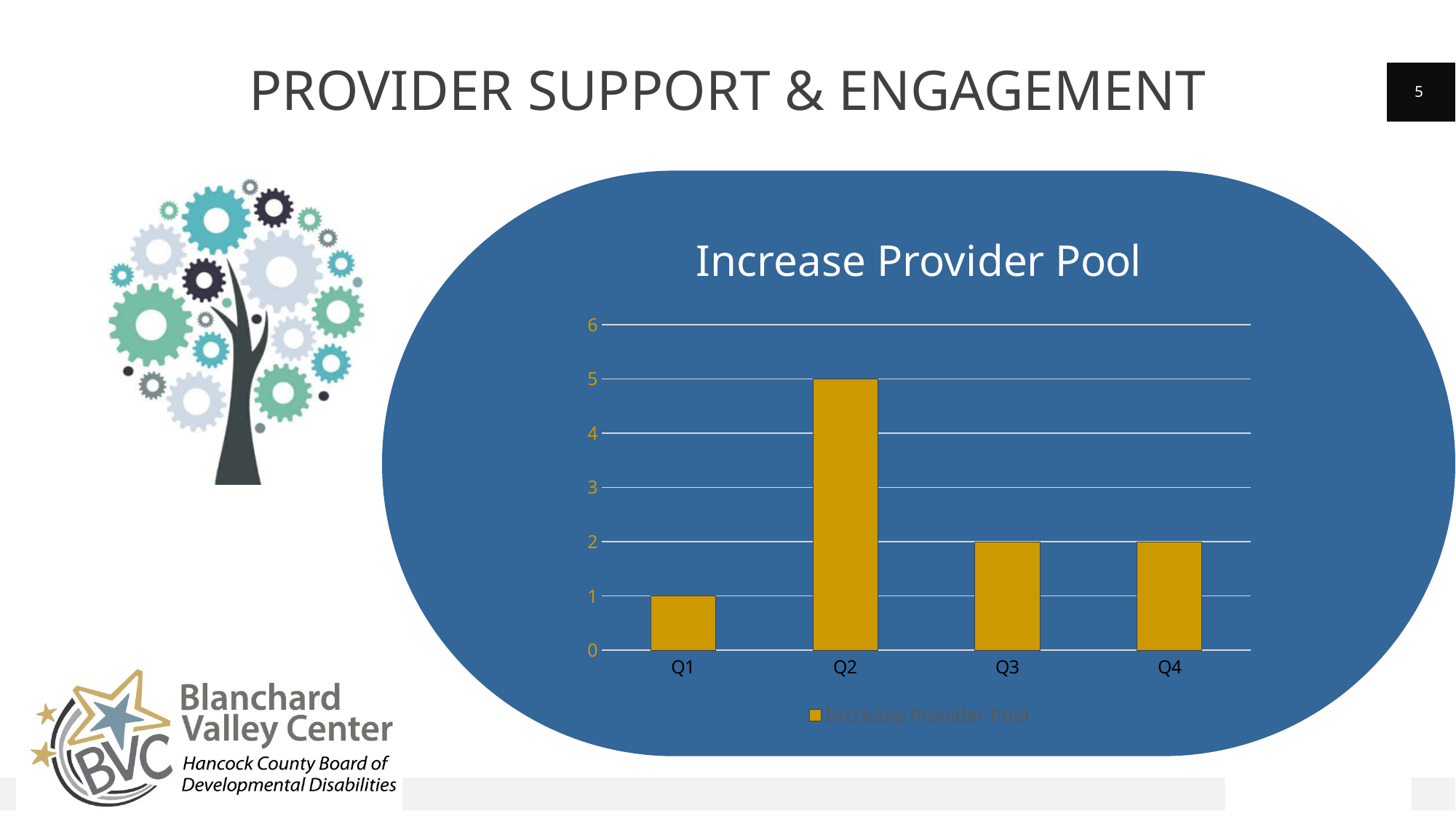
What is the value for Q4 in the Increase Provider Pool chart? 2 Which quarter has the highest value in the Increase Provider Pool chart? Q2 Which is larger in the Increase Provider Pool chart, the value for Q2 or the value for Q3? Q2 What kind of chart is the Increase Provider Pool chart? Bar chart How many series does the legend of the Increase Provider Pool chart list? 1 What is the value for Q2 in the Increase Provider Pool chart? 5 How many quarters are shown on the x axis of the Increase Provider Pool chart? 4 Which quarter has the lowest value in the Increase Provider Pool chart? Q1 What is the value for Q1 in the Increase Provider Pool chart? 1 Is the value for Q2 in the Increase Provider Pool chart greater or less than 4? greater What is the difference between the Q2 and Q1 values in the Increase Provider Pool chart? 4 What is the value for Q3 in the Increase Provider Pool chart? 2